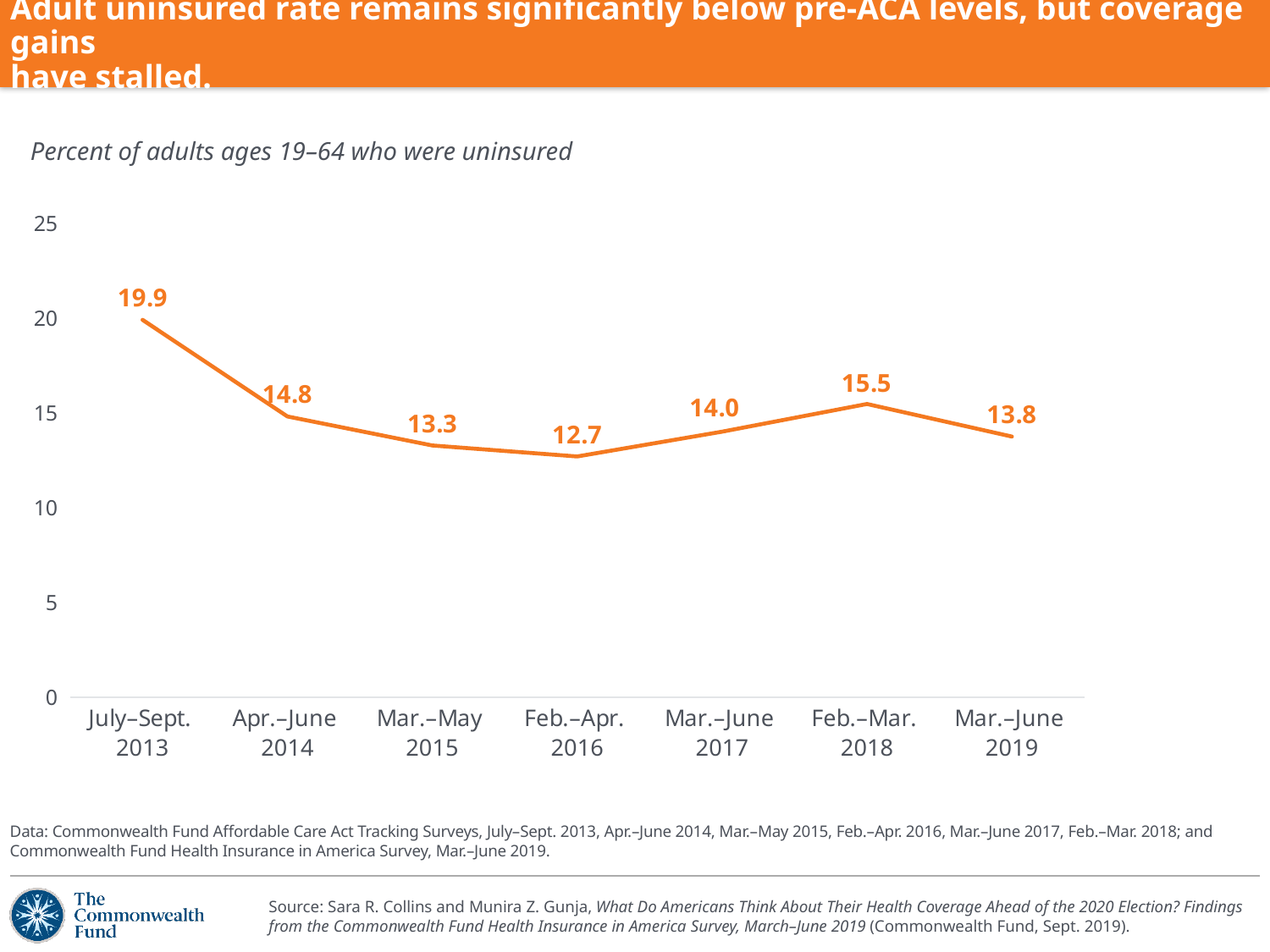
Is the uninsured rate for Mar.–May 2015 greater or less than 15? less Which survey period had the highest uninsured rate? July–Sept. 2013 What was the uninsured rate for adults ages 19–64 in July–Sept. 2013? 19.9 Which was higher, the uninsured rate in Apr.–June 2014 or in Mar.–June 2017? Apr.–June 2014 How many survey periods are plotted on the chart? 7 Which survey period had the lowest uninsured rate? Feb.–Apr. 2016 What was the uninsured rate in Feb.–Mar. 2018? 15.5 What was the uninsured rate in Mar.–June 2019? 13.8 What is the difference between the uninsured rate in Feb.–Mar. 2018 and Mar.–June 2019? 1.7 What type of chart is shown on the slide? line chart Did the uninsured rate rise or fall between Feb.–Apr. 2016 and Feb.–Mar. 2018? rise By how many percentage points did the uninsured rate fall from July–Sept. 2013 to Feb.–Apr. 2016? 7.2